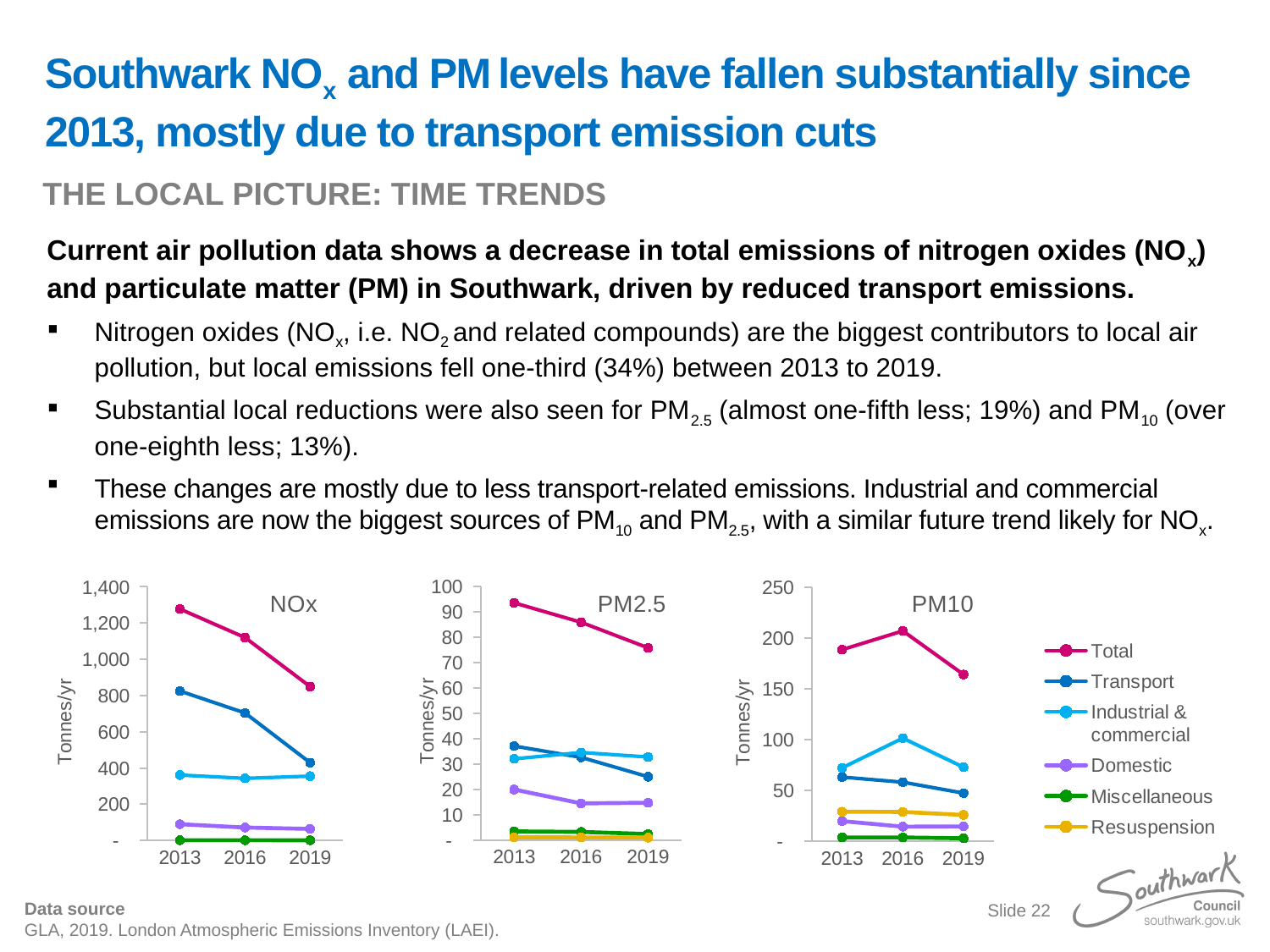
In the NOx chart, which series has the lowest values across all years? Miscellaneous How many series does the legend list for the charts? 6 In the PM2.5 chart, is the Total value for 2019 greater or less than 80? less What kind of chart is the NOx chart? line chart In the PM10 chart, is the Total value for 2016 greater or less than 200? greater In the PM10 chart, which is larger in 2016: Transport or Industrial & commercial? Industrial & commercial How many years are plotted on the x axis of the PM2.5 chart? 3 In the NOx chart, is the Transport value for 2019 greater or less than 600? less What is the y-axis label on the PM2.5 chart? Tonnes/yr In the NOx chart, does the Total series rise or fall from 2013 to 2019? fall In the PM10 chart, which year has the highest Total value? 2016